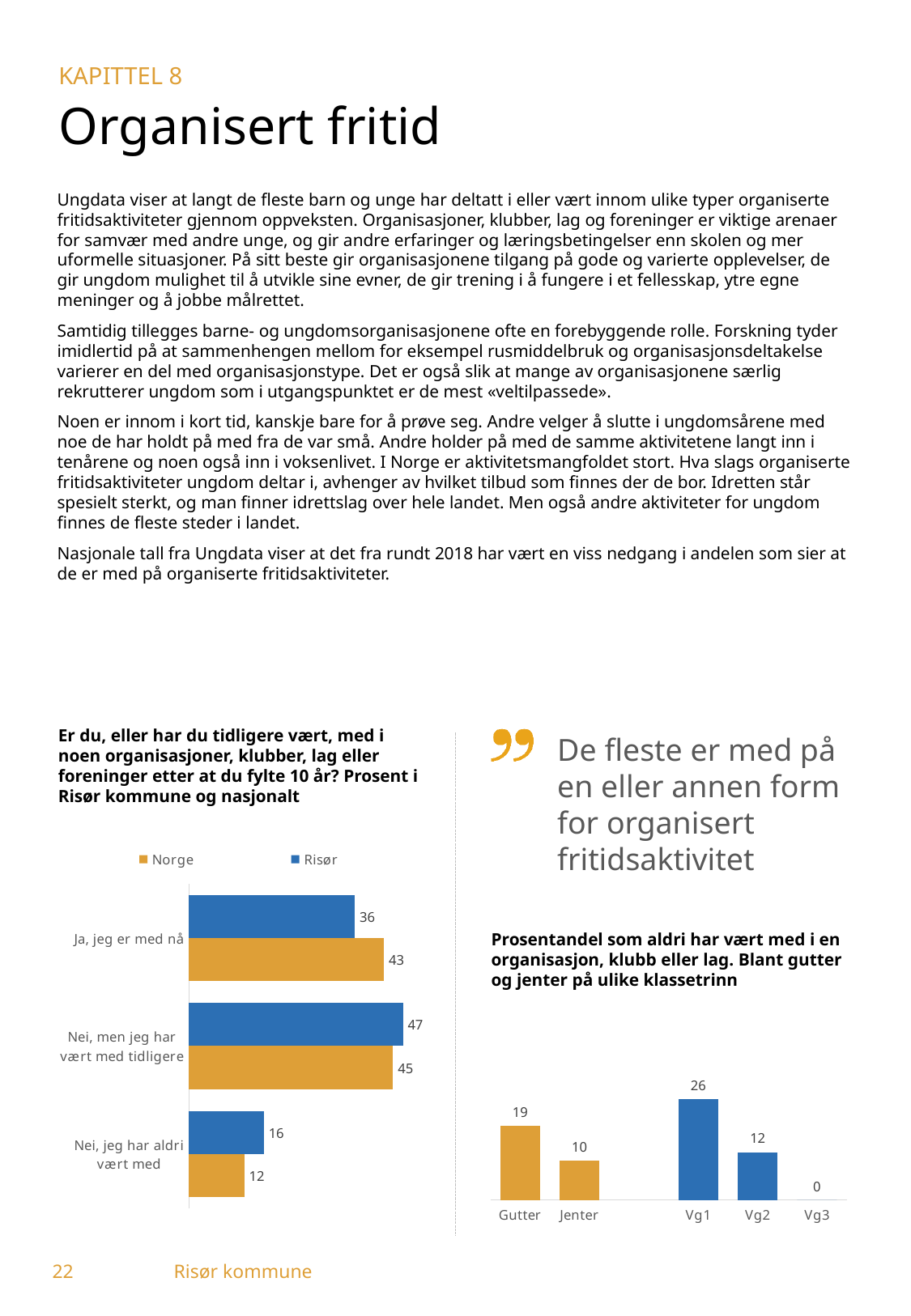
In the left chart ("Er du, eller har du tidligere vært, med i noen organisasjoner..."), what is the value for Risør for "Ja, jeg er med nå"? 36 In the right chart, what is the difference between Gutter and Jenter? 9 In the right chart, how many categories are shown on the x axis? 5 In the left chart, which category has the highest value for Risør? Nei, men jeg har vært med tidligere In the right chart ("Prosentandel som aldri har vært med i en organisasjon..."), what is the value for Vg1? 26 In the left chart, which is larger for "Nei, men jeg har vært med tidligere": Norge or Risør? Risør In the left chart, which colour represents Norge? Orange In the left chart, how many series does the legend list? 2 In the right chart, which category has the lowest value? Vg3 In the left chart, what is the difference between Norge and Risør for "Ja, jeg er med nå"? 7 What kind of chart is the left chart? Bar chart In the left chart, what is the value for Norge for "Nei, jeg har aldri vært med"? 12